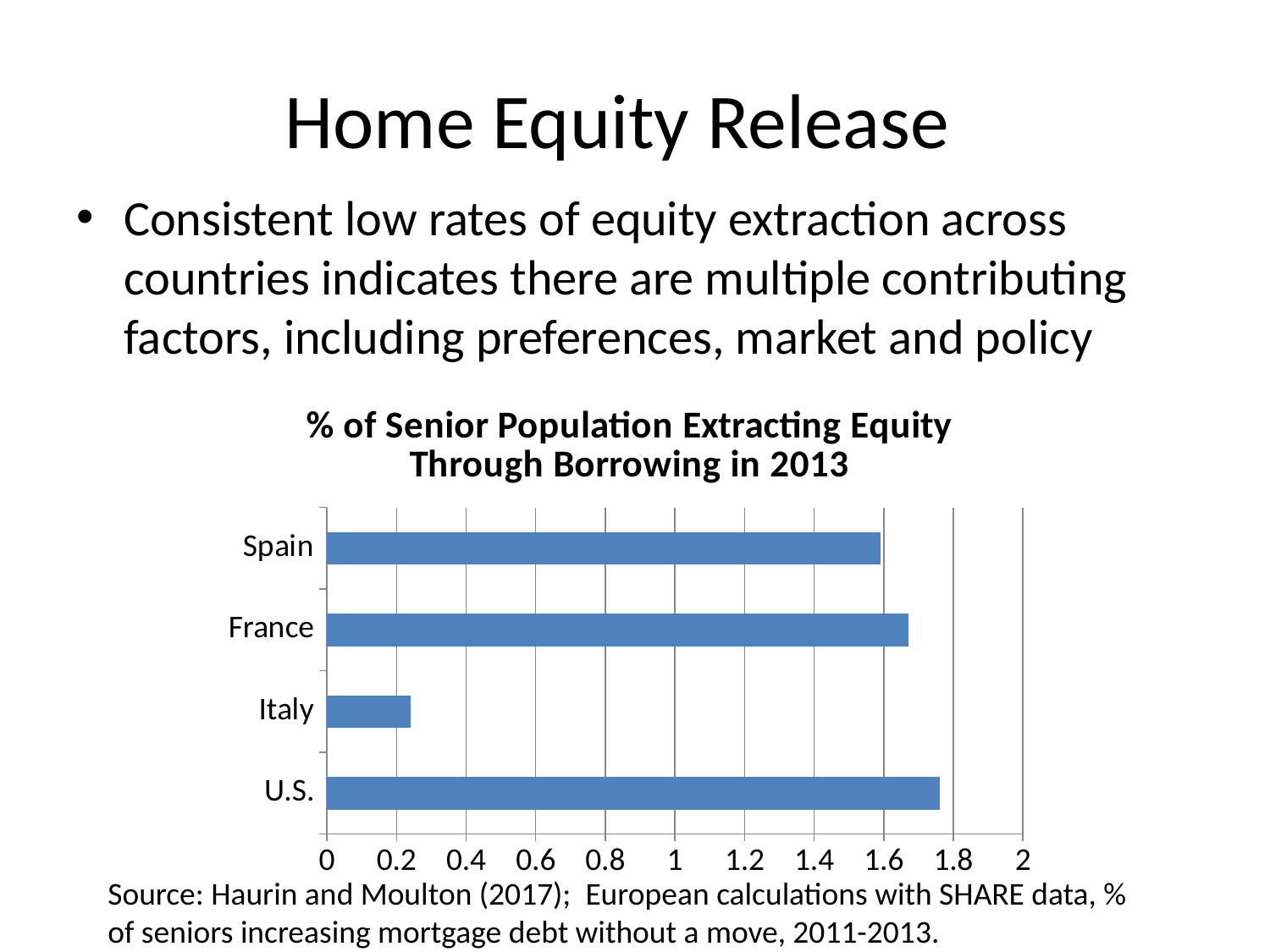
Which has a larger value, U.S. or Spain? U.S. What is the title of the chart? % of Senior Population Extracting Equity Through Borrowing in 2013 What kind of chart is shown on the slide? bar chart Which has a larger value, Italy or Spain? Spain Is the value for Italy greater or less than 0.4? less Is the value for Spain greater or less than 1.4? greater Which country has the lowest % of senior population extracting equity through borrowing? Italy How many countries are shown in the chart? 4 Which country has the highest % of senior population extracting equity through borrowing? U.S. Is the value for U.S. greater or less than 1.6? greater What is the maximum value shown on the horizontal axis of the chart? 2